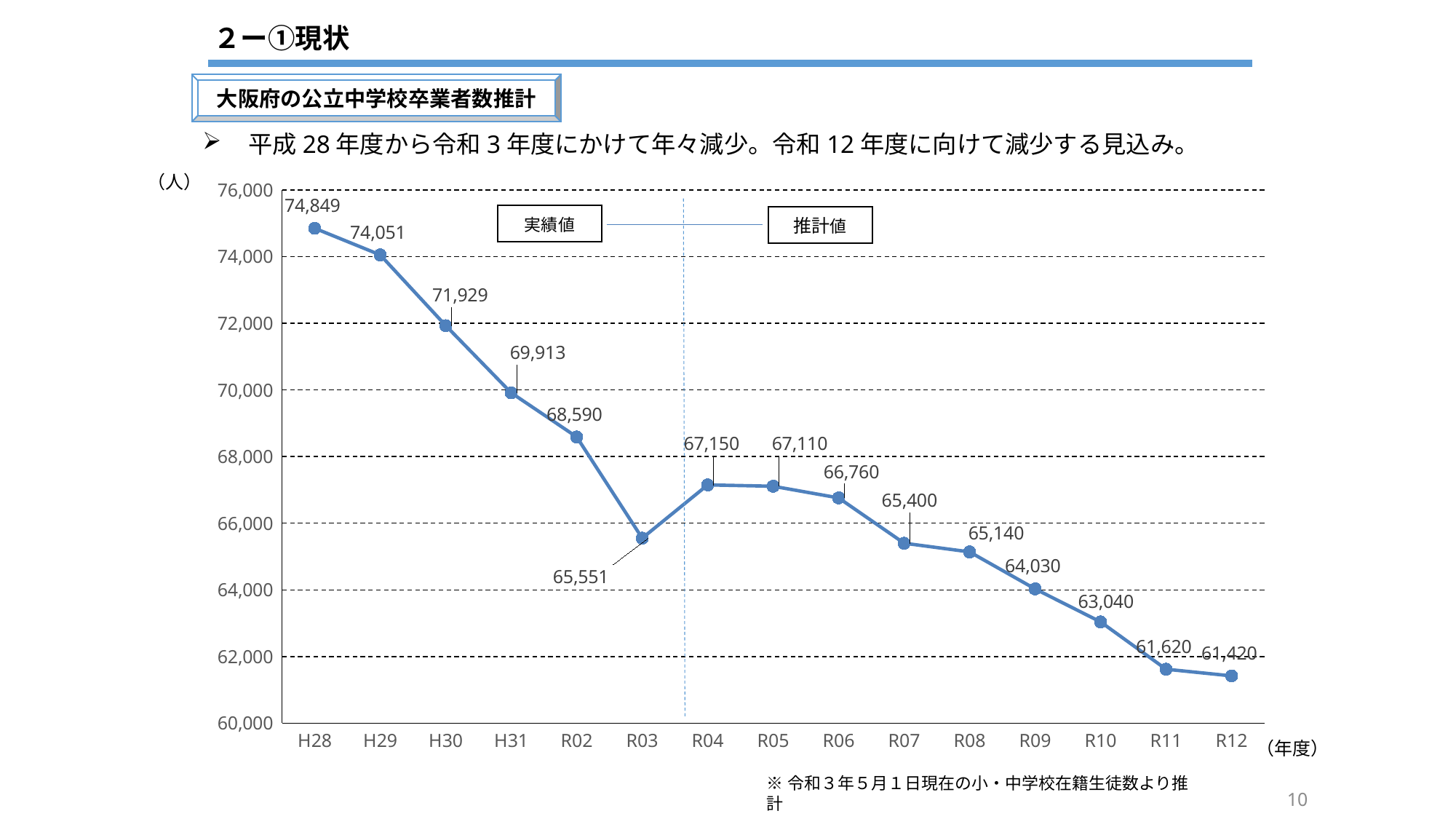
What is the value for R03? 65,551 Which year has the highest value? H28 Which is larger, the value for R04 or the value for R05? R04 What is the value for R12? 61,420 Do the values generally rise or fall from H28 to R03? Fall What kind of chart is shown on the slide? Line chart What is the value for H28? 74,849 How many data points are plotted on the chart? 15 What is the difference between the values for H28 and R12? 13,429 What is the value for R06? 66,760 Which year has the lowest value? R12 What is the difference between the values for R03 and R04? 1,599